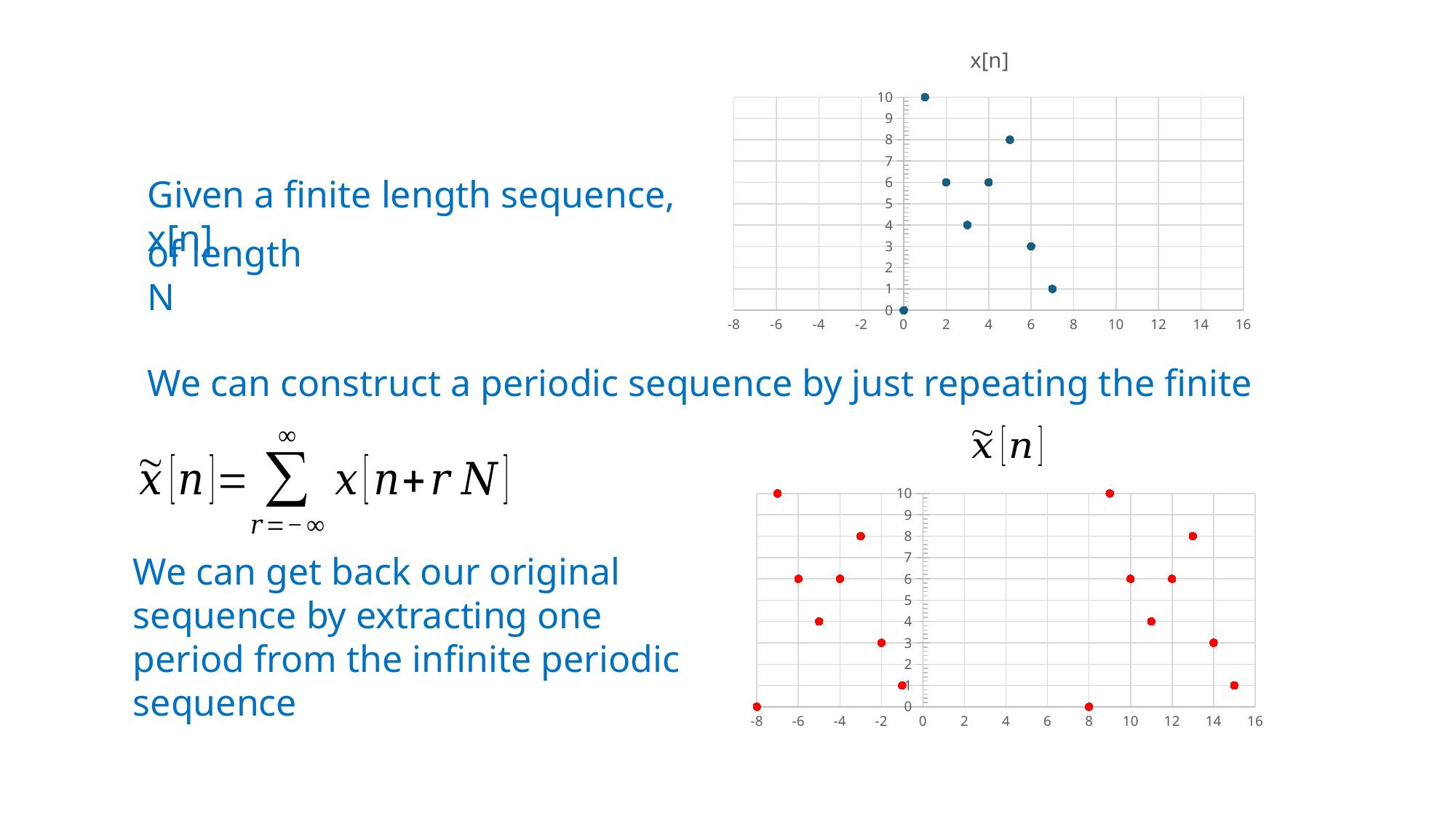
What colour are the markers in the bottom chart? red In the top chart titled x[n], what is the value at n = 5? 8 In the top chart titled x[n], which is larger, the value at n = 3 or the value at n = 7? n = 3 In the top chart titled x[n], what is the difference between the values at n = 2 and n = 6? 3 In the bottom chart, what is the value at n = -7? 10 In the top chart titled x[n], at which n is the value highest? 1 What kind of chart is the top chart titled x[n]? scatter chart In the top chart titled x[n], at which n is the value lowest? 0 In the top chart titled x[n], what is the value at n = 1? 10 In the bottom chart, how many data points are plotted? 16 In the bottom chart, what is the value at n = 13? 8 In the top chart titled x[n], how many data points are plotted? 8